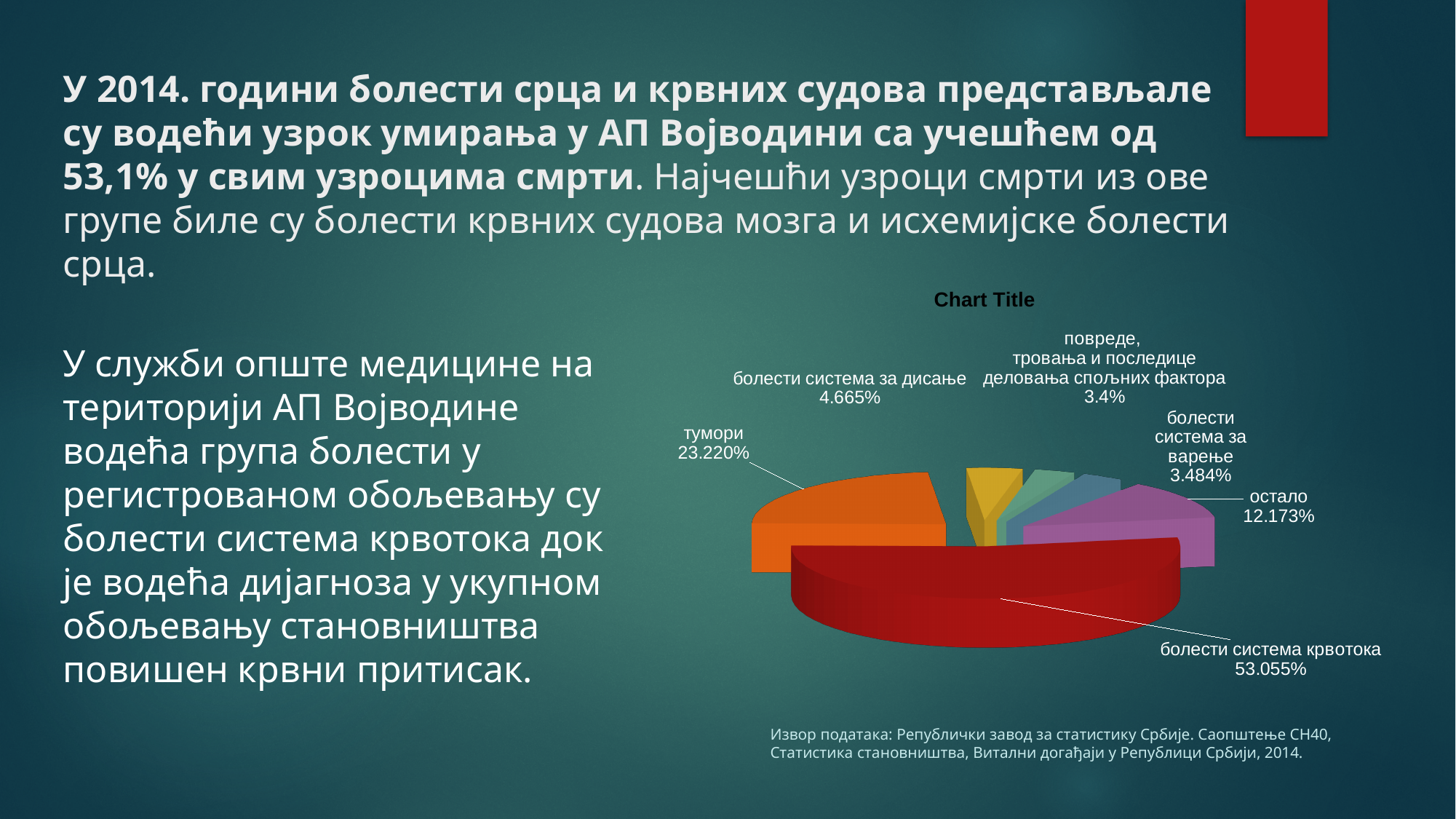
What share of the pie is labelled for тумори? 23.220% What kind of chart is shown on the slide? pie chart What share of the pie is labelled for остало? 12.173% What share of the pie is labelled for болести система крвотока? 53.055% What share of the pie is labelled for болести система за варење? 3.484% What share of the pie is labelled for болести система за дисање? 4.665% Which slice is larger: тумори or остало? тумори What is the difference in percentage points between болести система крвотока and тумори? 29.835 Which category has the largest slice of the pie? болести система крвотока What is the title of the chart? Chart Title How many slices does the pie chart have? 6 Which category has the smallest slice of the pie? повреде, тровања и последице деловања спољних фактора